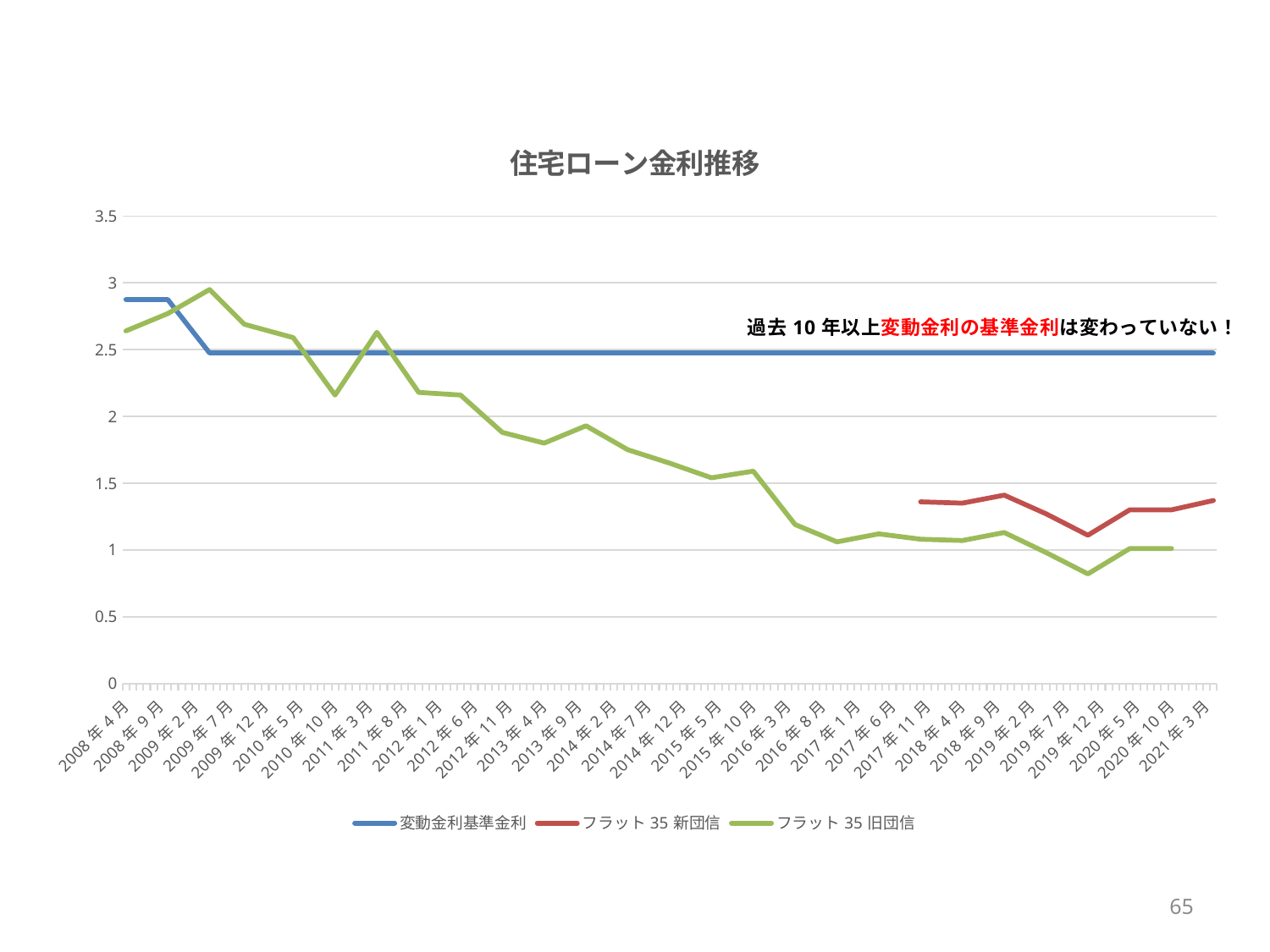
At 2019年12月, which is higher: フラット35 新団信 or フラット35 旧団信? フラット35 新団信 What is the title of the chart? 住宅ローン金利推移 Does フラット35 旧団信 generally rise or fall from 2008年4月 to 2021年3月? fall At which x-axis label does フラット35 旧団信 reach its lowest value? 2019年12月 How many series does the legend list? 3 Is the value for 変動金利基準金利 at 2021年3月 greater or less than 2? greater Is the value for フラット35 旧団信 at 2019年12月 greater or less than 1? less Is the value for フラット35 旧団信 at 2008年4月 greater or less than 2.5? greater Which series is drawn in blue? 変動金利基準金利 What kind of chart is shown on the slide? line chart At which x-axis label does フラット35 旧団信 reach its highest value? 2009年2月